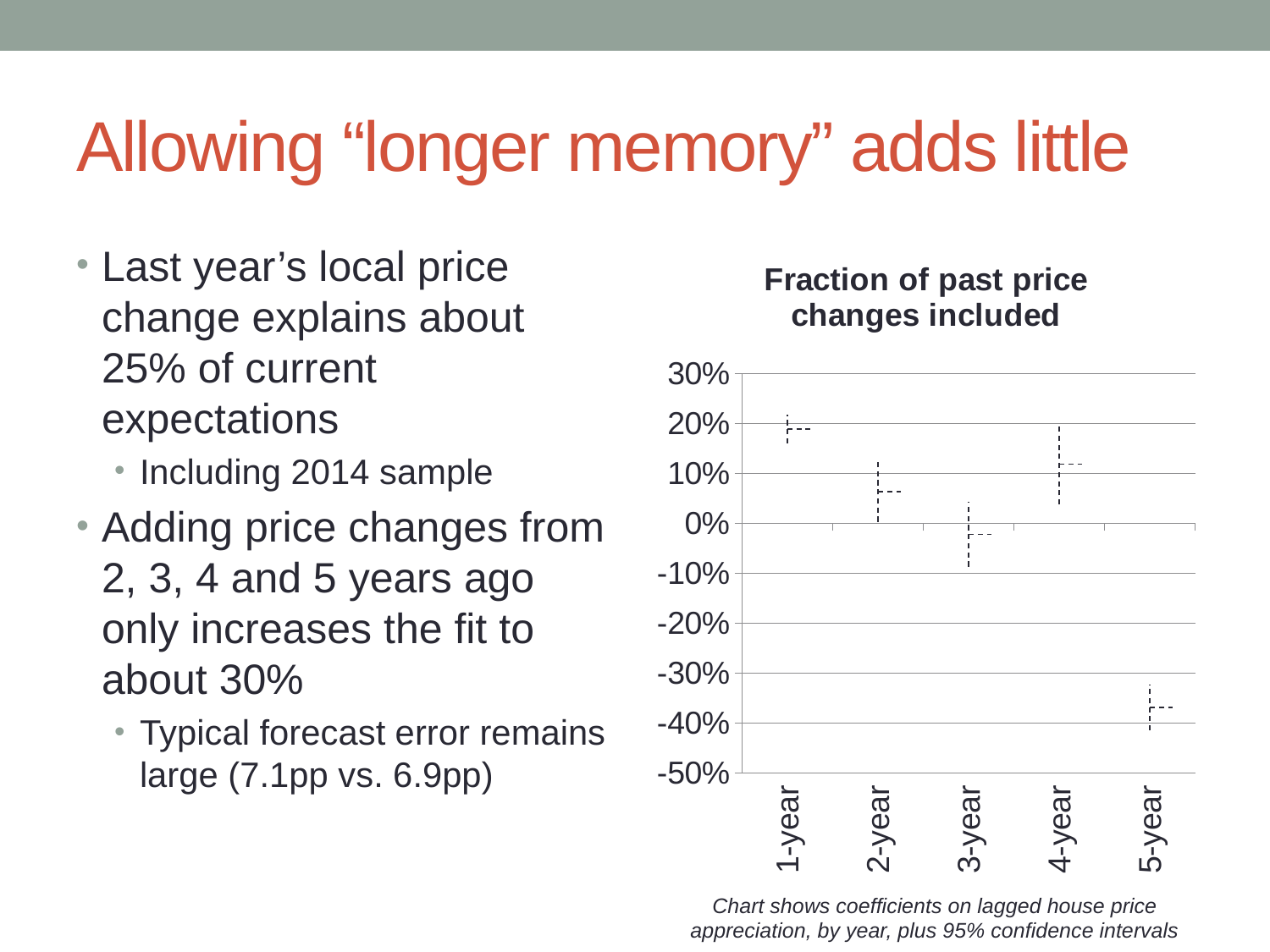
Which is larger, the value for 2-year or the value for 5-year? 2-year Is the value for 5-year greater or less than -20%? less What is the lowest value shown on the chart's y axis? -50% Is the value for 1-year greater or less than 10%? greater Is the value for 2-year greater or less than 0%? greater Which is larger, the value for 4-year or the value for 3-year? 4-year Which category has the lowest coefficient in the chart? 5-year What is the title of the chart? Fraction of past price changes included Which is larger, the value for 1-year or the value for 2-year? 1-year Which category has the highest coefficient in the chart? 1-year How many categories are shown on the x axis of the chart? 5